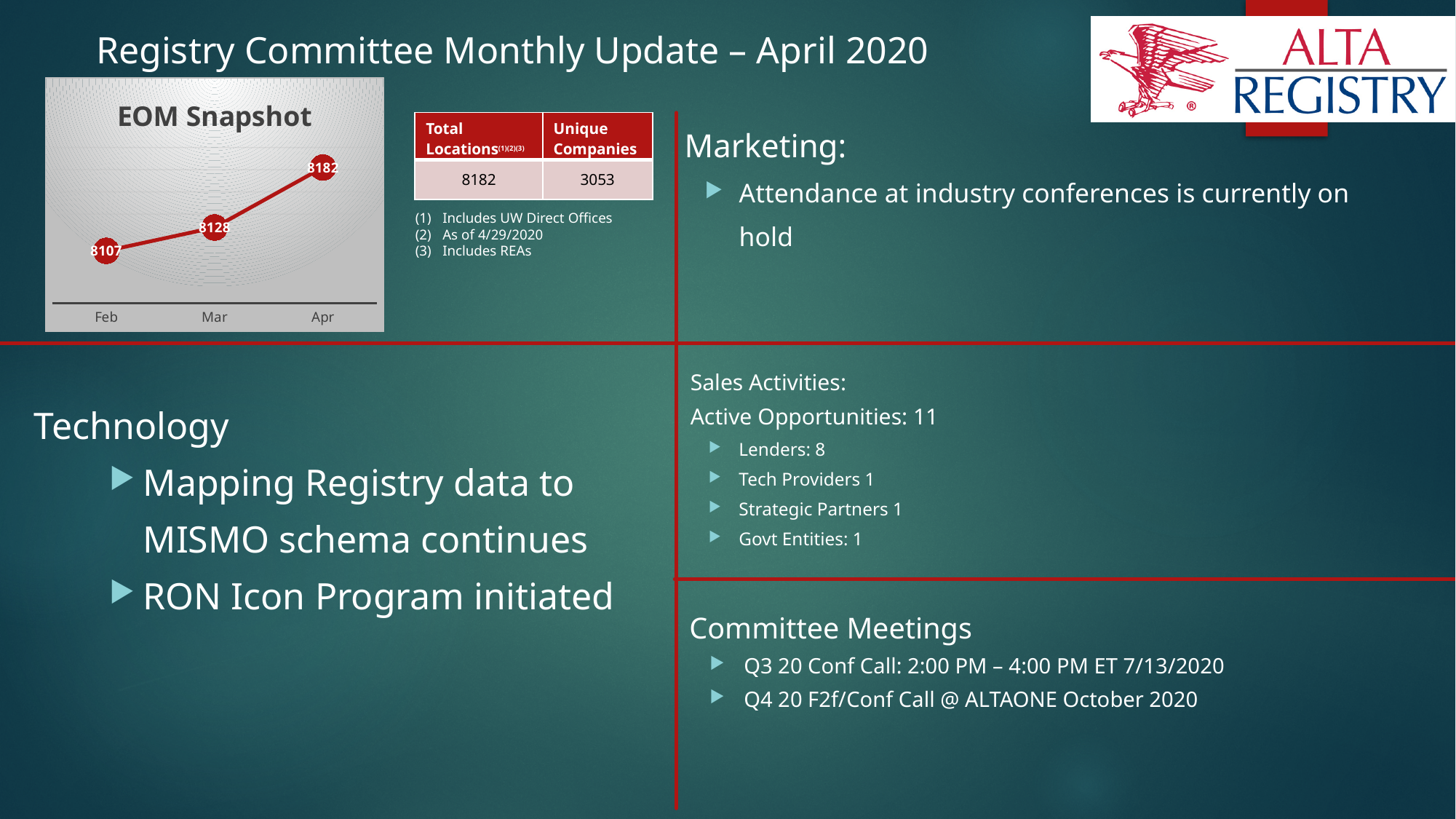
What is the difference between the Apr and Feb values in the EOM Snapshot chart? 75 Which month has the highest value in the EOM Snapshot chart? Apr What is the title of the chart on the slide? EOM Snapshot In the EOM Snapshot chart, is the value for Apr larger or smaller than the value for Mar? larger What is the value for Feb in the EOM Snapshot chart? 8107 What is the difference between the Mar and Feb values in the EOM Snapshot chart? 21 What kind of chart is the EOM Snapshot? line chart What is the value for Apr in the EOM Snapshot chart? 8182 Do the values in the EOM Snapshot chart rise or fall from Feb to Apr? rise How many months are plotted in the EOM Snapshot chart? 3 What is the value for Mar in the EOM Snapshot chart? 8128 Which month has the lowest value in the EOM Snapshot chart? Feb